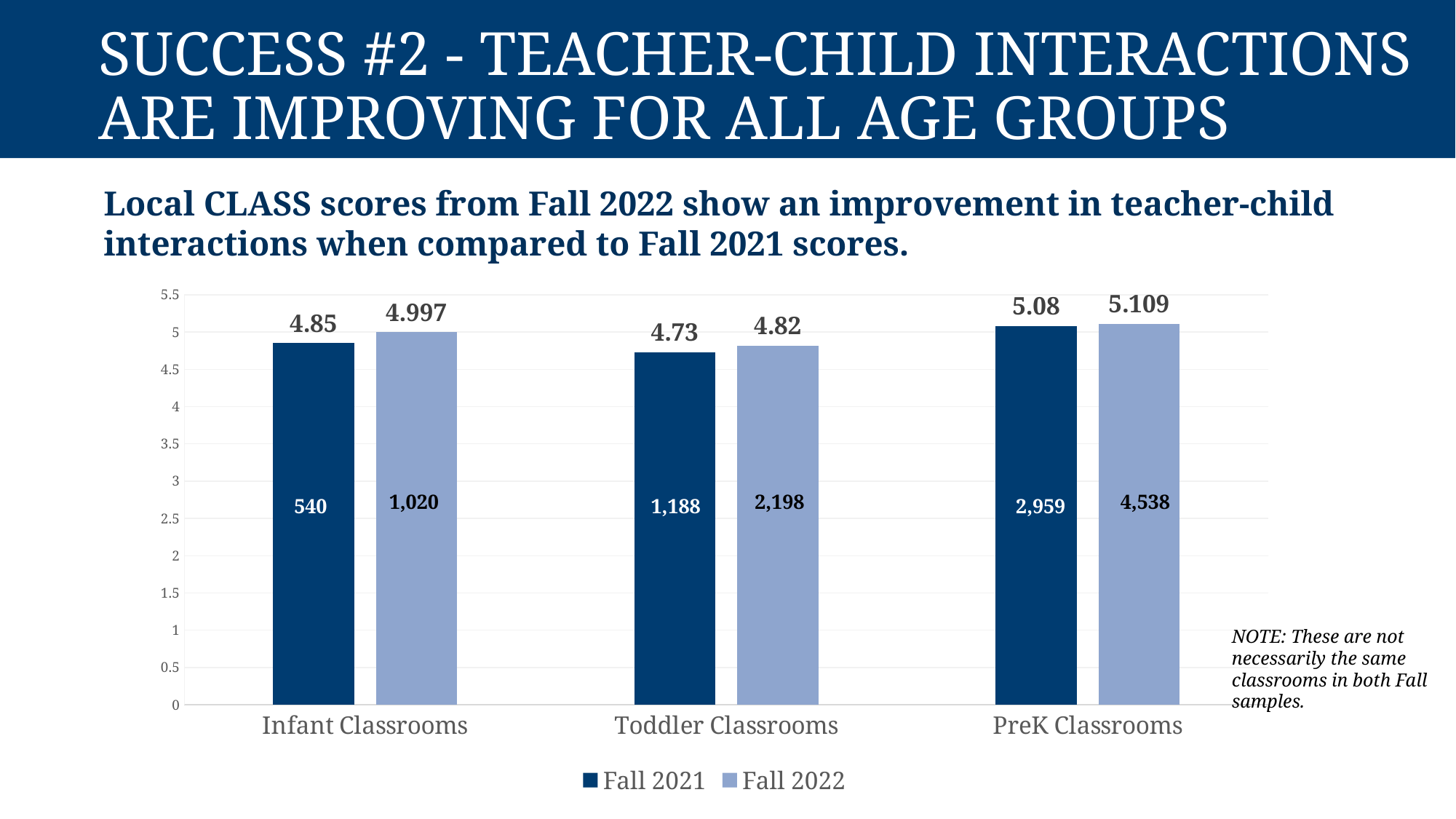
How many classroom categories are shown on the x axis? 3 What is the Fall 2022 CLASS score for Toddler Classrooms? 4.82 What number is printed inside the Fall 2022 bar for Infant Classrooms? 1,020 How many series does the legend list? 2 What is the Fall 2021 CLASS score for Infant Classrooms? 4.85 Is the Fall 2021 CLASS score for PreK Classrooms greater or less than 5? greater What is the Fall 2022 CLASS score for PreK Classrooms? 5.109 What is the difference between the Fall 2022 and Fall 2021 CLASS scores for Toddler Classrooms? 0.09 Which classroom type has the lowest Fall 2021 CLASS score? Toddler Classrooms Which is larger for Infant Classrooms, the Fall 2021 score or the Fall 2022 score? Fall 2022 What kind of chart is shown on the slide? Bar chart Which classroom type has the highest Fall 2022 CLASS score? PreK Classrooms